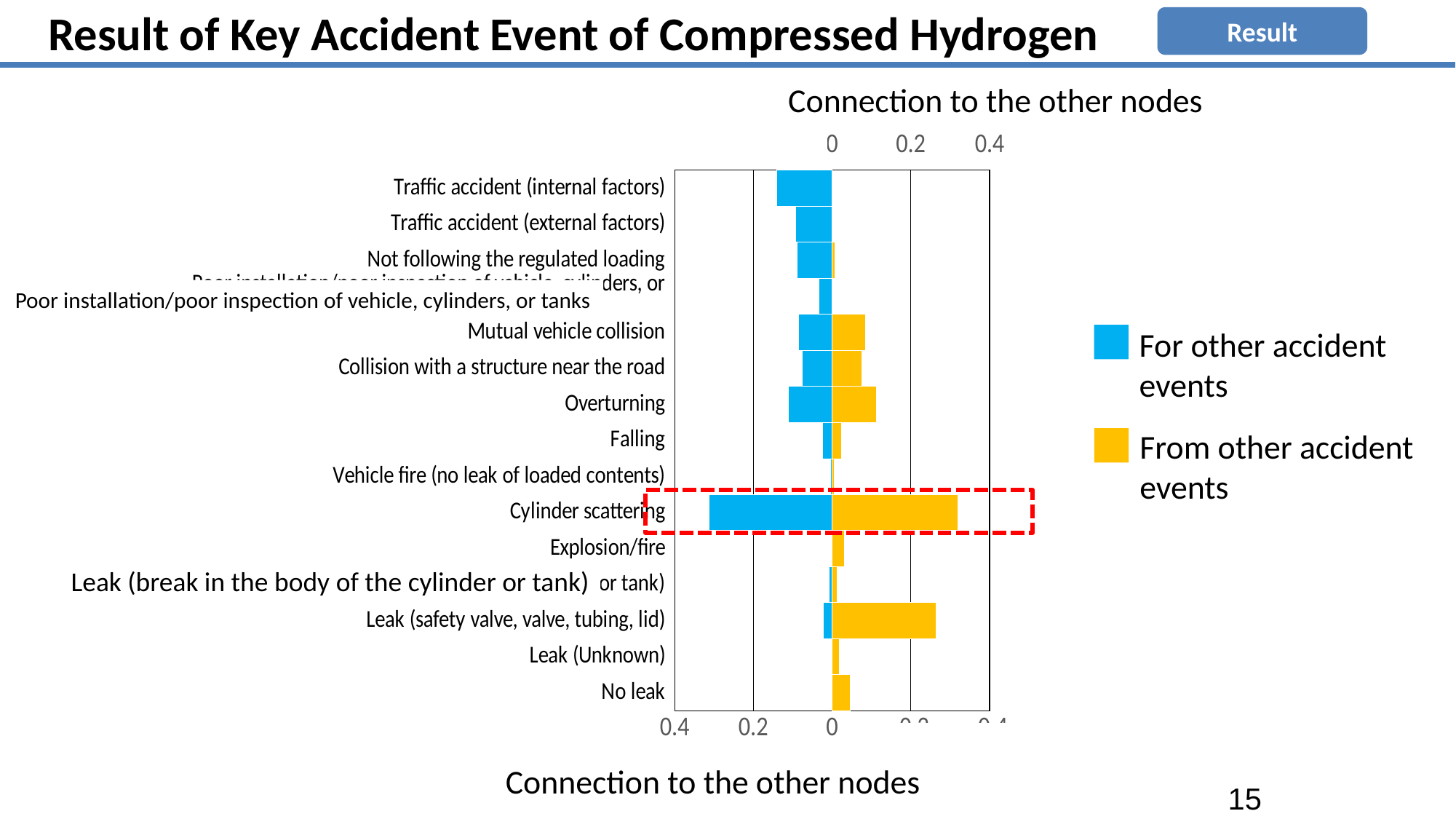
Which has the larger 'For other accident events' value: Traffic accident (internal factors) or Traffic accident (external factors)? Traffic accident (internal factors) What kind of chart is shown on the slide? Bar chart Which category has the longest bar for the 'From other accident events' series? Cylinder scattering Which colour represents the 'From other accident events' series? Yellow How many accident event categories are plotted on the chart? 15 Which category has the longest bar for the 'For other accident events' series? Cylinder scattering Which category is highlighted with a red dashed box on the chart? Cylinder scattering Is the 'For other accident events' value for Cylinder scattering greater or less than 0.2? greater Is the 'From other accident events' value for Cylinder scattering greater or less than 0.2? greater Is the 'From other accident events' value for Leak (safety valve, valve, tubing, lid) greater or less than 0.2? greater How many series does the legend list? 2